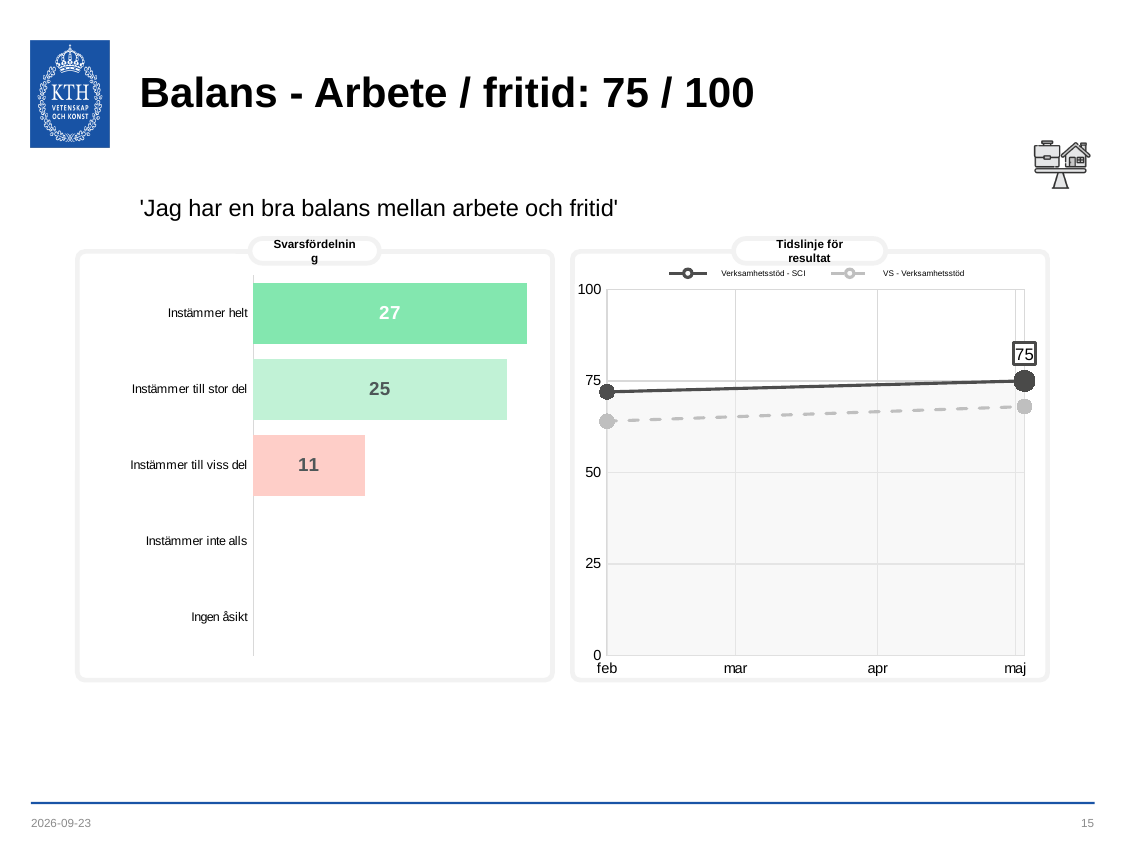
In the 'Tidslinje för resultat' chart, is the value for 'VS - Verksamhetsstöd' in feb greater or less than 75? less In the 'Svarsfördelning' chart, what is the difference between 'Instämmer helt' and 'Instämmer till viss del'? 16 What kind of chart is the 'Svarsfördelning' chart? bar chart How many series does the legend of the 'Tidslinje för resultat' chart list? 2 In the 'Svarsfördelning' chart, what is the value for 'Instämmer till stor del'? 25 In the 'Svarsfördelning' chart, what is the value for 'Instämmer helt'? 27 In the 'Svarsfördelning' chart, what is the value for 'Instämmer till viss del'? 11 What kind of chart is the 'Tidslinje för resultat' chart? line chart In the 'Svarsfördelning' chart, which is larger: 'Instämmer till stor del' or 'Instämmer till viss del'? Instämmer till stor del How many categories are listed on the 'Svarsfördelning' chart? 5 In the 'Svarsfördelning' chart, which category has the highest value? Instämmer helt In the 'Tidslinje för resultat' chart, what is the labelled value for 'Verksamhetsstöd - SCI' in maj? 75